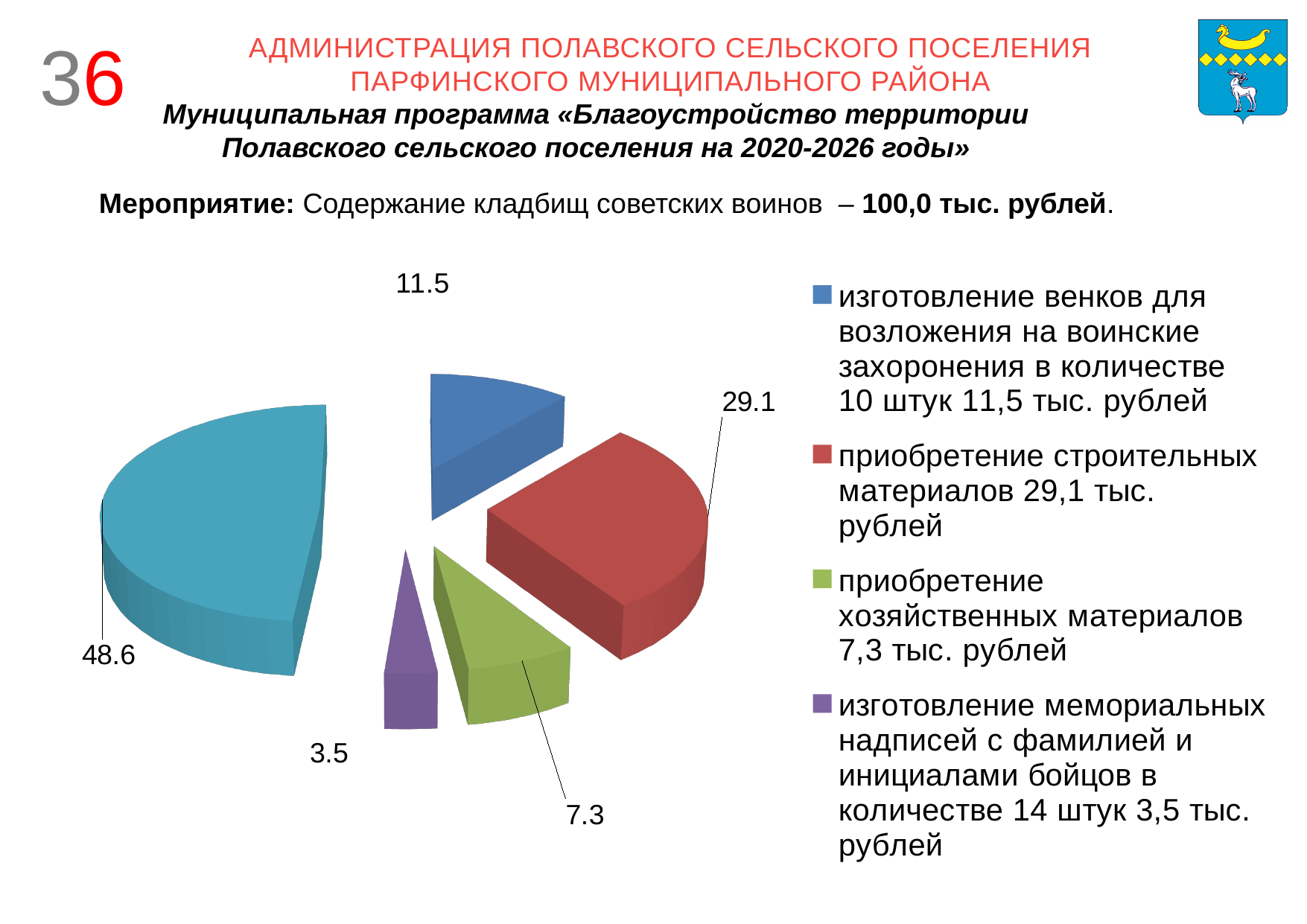
How many slices does the pie chart have? 5 What colour is the slice labelled 29.1? red How many entries does the legend list? 4 What is the value of the largest slice in the pie chart? 48.6 What value is shown for the slice 'приобретение строительных материалов'? 29.1 What value is shown for the slice 'изготовление мемориальных надписей с фамилией и инициалами бойцов'? 3.5 What type of chart is shown on the slide? pie chart What is the difference between the slice for 'приобретение строительных материалов' and the slice for 'изготовление венков'? 17.6 Which is larger: the slice for 'приобретение хозяйственных материалов' or the slice for 'изготовление мемориальных надписей'? приобретение хозяйственных материалов What value is shown for the slice 'приобретение хозяйственных материалов'? 7.3 Which legend category has the smallest slice in the pie chart? изготовление мемориальных надписей с фамилией и инициалами бойцов What value is shown for the slice 'изготовление венков для возложения на воинские захоронения'? 11.5